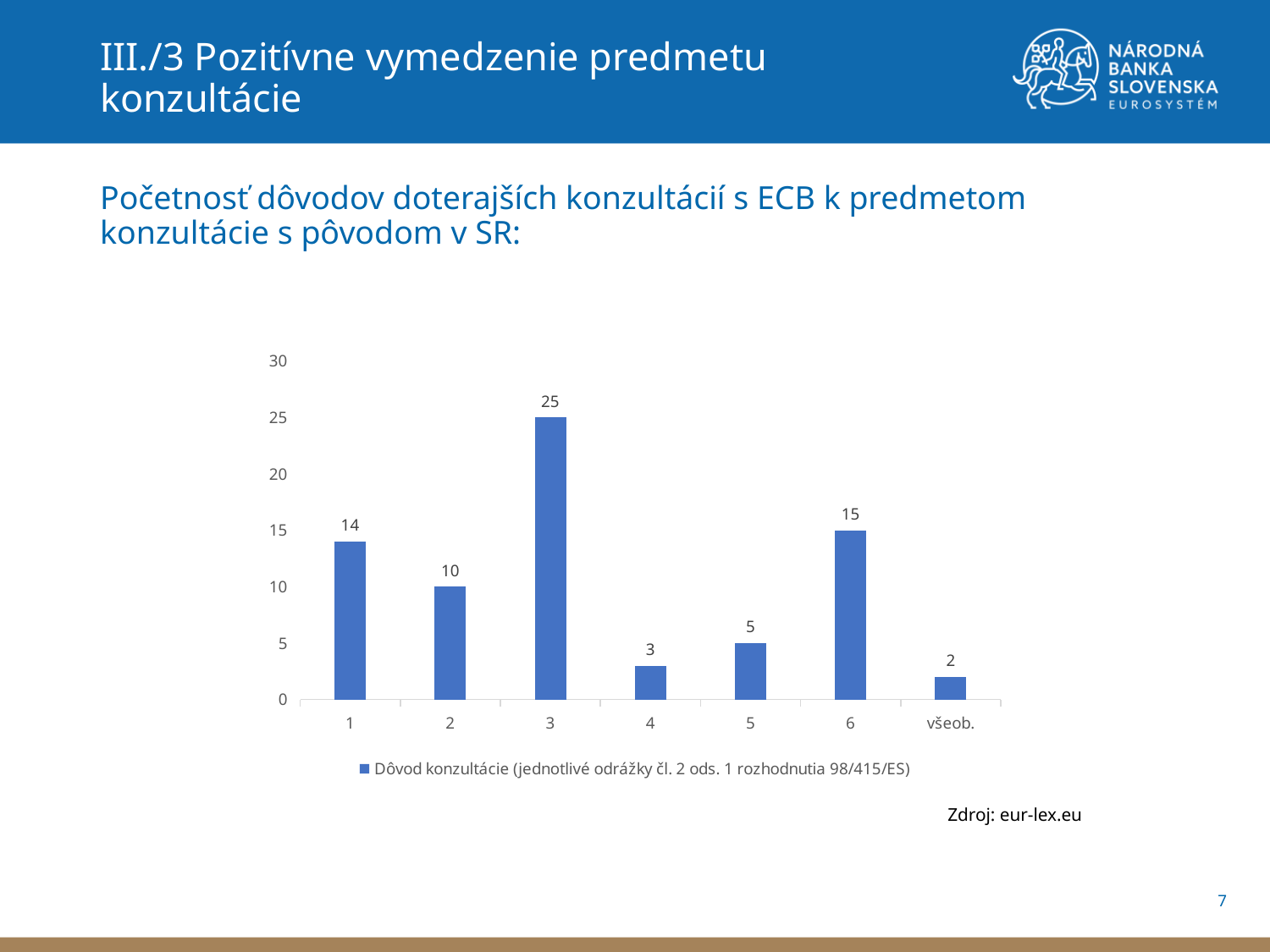
Which category has the highest value? 3 Which category has the lowest value? všeob. How many categories are shown on the x axis? 7 How many series does the legend list? 1 Is the value for category 4 greater or less than 5? less What kind of chart is shown on the slide? bar chart What is the value for category 'všeob.'? 2 What source is cited below the chart? eur-lex.eu Which is larger, the value for category 1 or the value for category 2? 1 What is the difference between the values for category 3 and category 6? 10 What is the value for category 3? 25 What is the value for category 6? 15